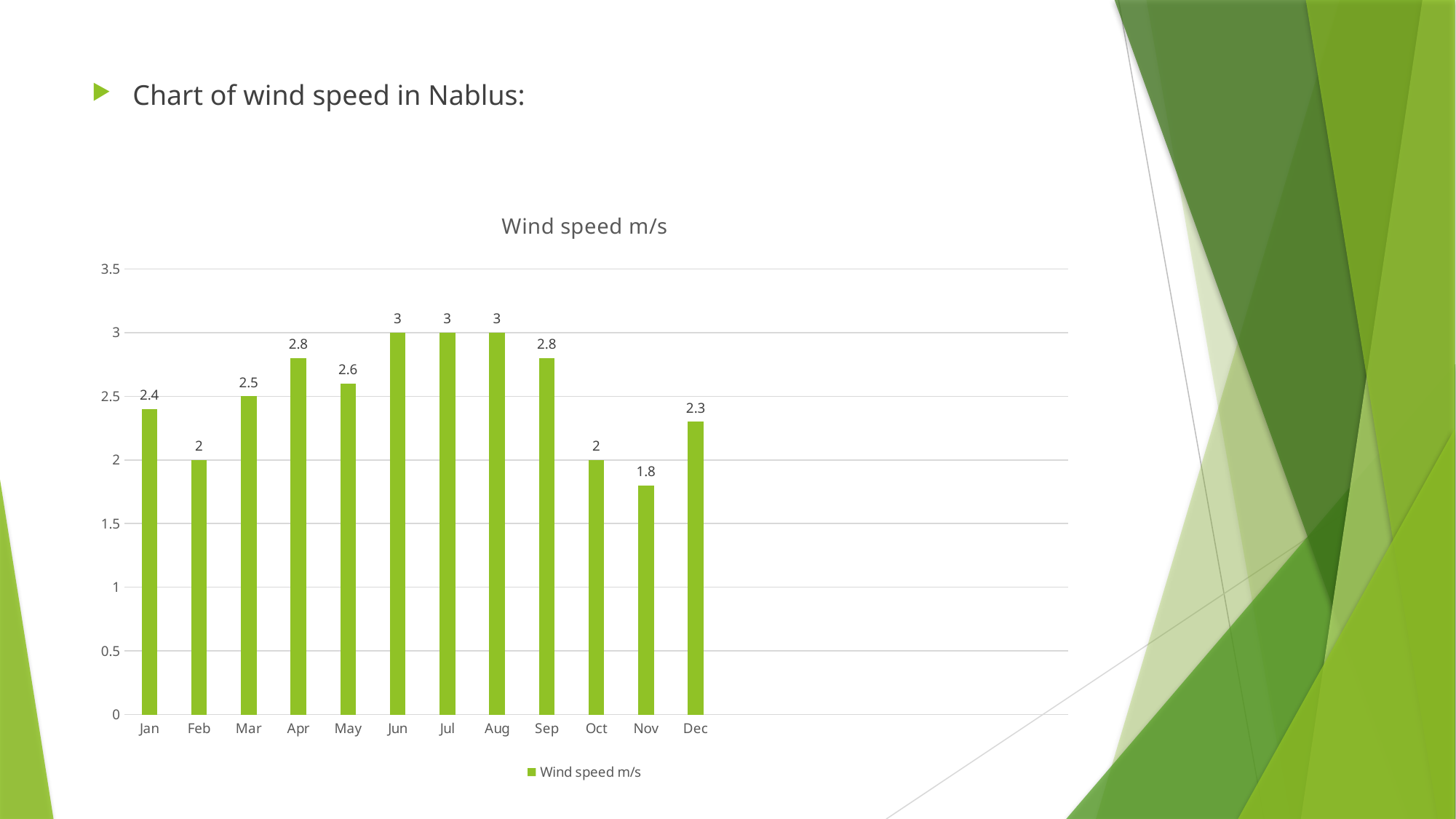
How many series does the legend list? 1 What is the title of the chart? Wind speed m/s What is the wind speed for Nov? 1.8 Which month has the lowest wind speed? Nov What is the wind speed for Sep? 2.8 What is the wind speed for Jan? 2.4 How many months are shown on the x axis? 12 What is the difference between the wind speed in Dec and the wind speed in Nov? 0.5 What is the difference between the wind speed in Aug and the wind speed in Feb? 1 Which is larger, the wind speed in Mar or the wind speed in May? May Is the value for Apr greater or less than 2.5? greater What kind of chart is shown? bar chart